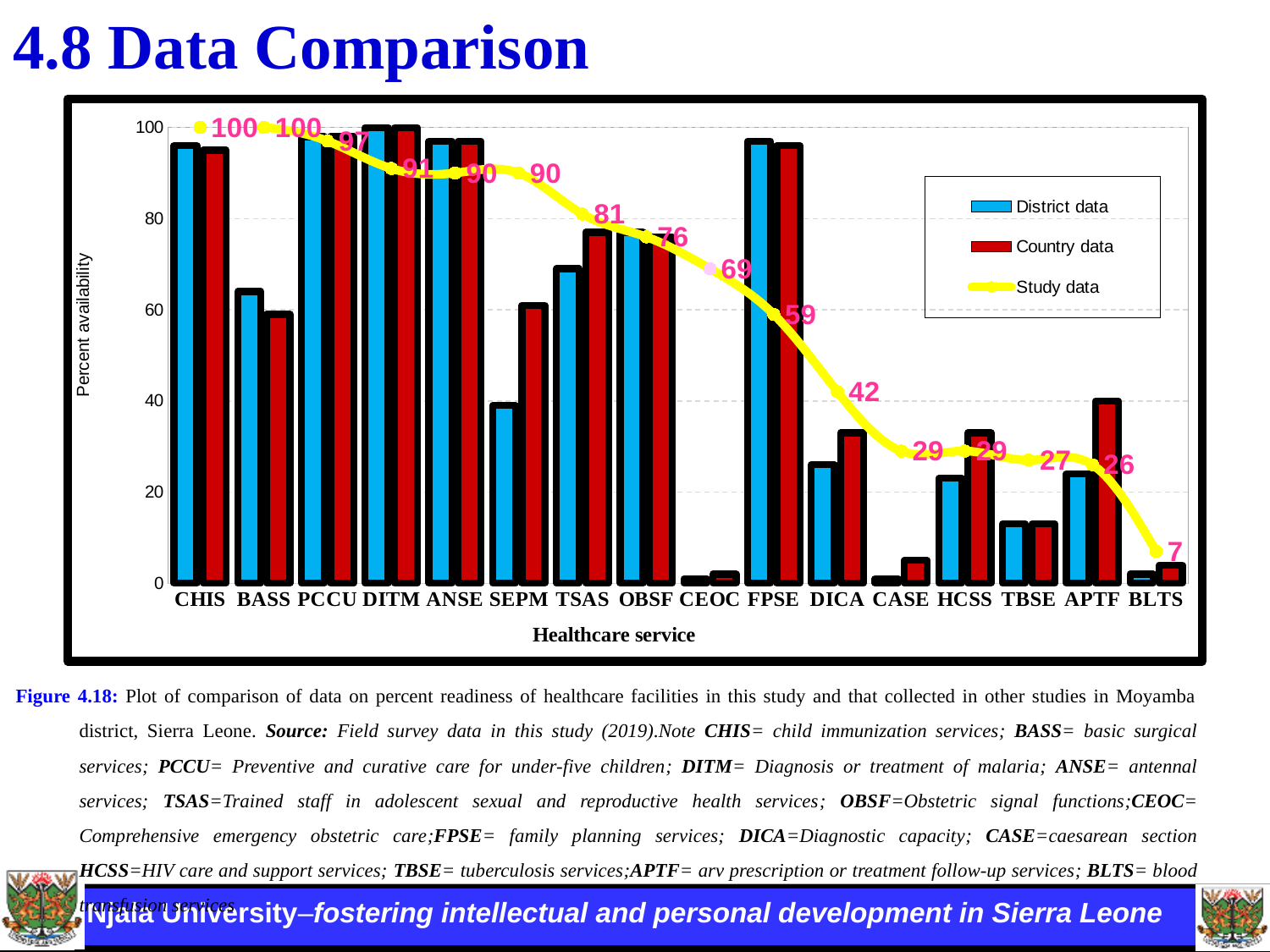
Is the District data value for CHIS greater or less than 80? greater What is the Study data value for DICA? 42 Which has a higher Study data value, OBSF or CASE? OBSF What kind of chart is used for the District data and Country data series? Bar chart Is the Country data value for CEOC greater or less than 20? less Which healthcare service has the lowest Study data value? BLTS How many series does the legend list? 3 Does the Study data line generally rise or fall from CHIS to BLTS? Fall How many healthcare services are shown on the x axis? 16 What is the Study data value for BLTS? 7 What is the difference between the Study data values for PCCU and FPSE? 38 What is the Study data value for TSAS? 81